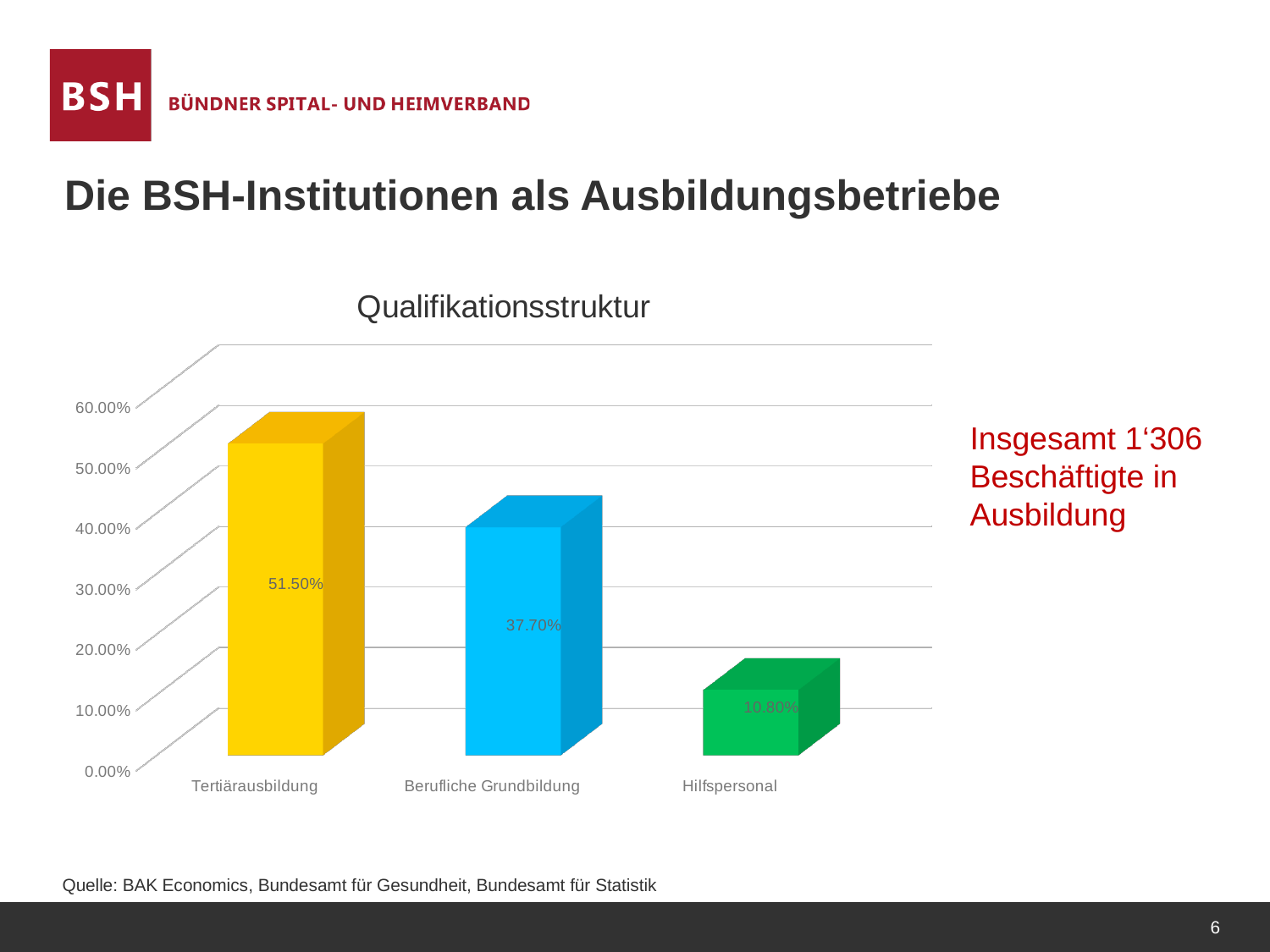
What is the value for Tertiärausbildung? 51.50% How many categories are shown in the chart? 3 Which category has the lowest value? Hilfspersonal Which category has the highest value? Tertiärausbildung What is the title of the chart? Qualifikationsstruktur What is the difference between the values for Berufliche Grundbildung and Hilfspersonal? 26.90% Which is larger, the value for Berufliche Grundbildung or the value for Hilfspersonal? Berufliche Grundbildung What is the value for Berufliche Grundbildung? 37.70% Is the value for Berufliche Grundbildung greater or less than 30.00%? greater What is the value for Hilfspersonal? 10.80% What is the difference between the values for Tertiärausbildung and Berufliche Grundbildung? 13.80% What kind of chart is shown on the slide? bar chart